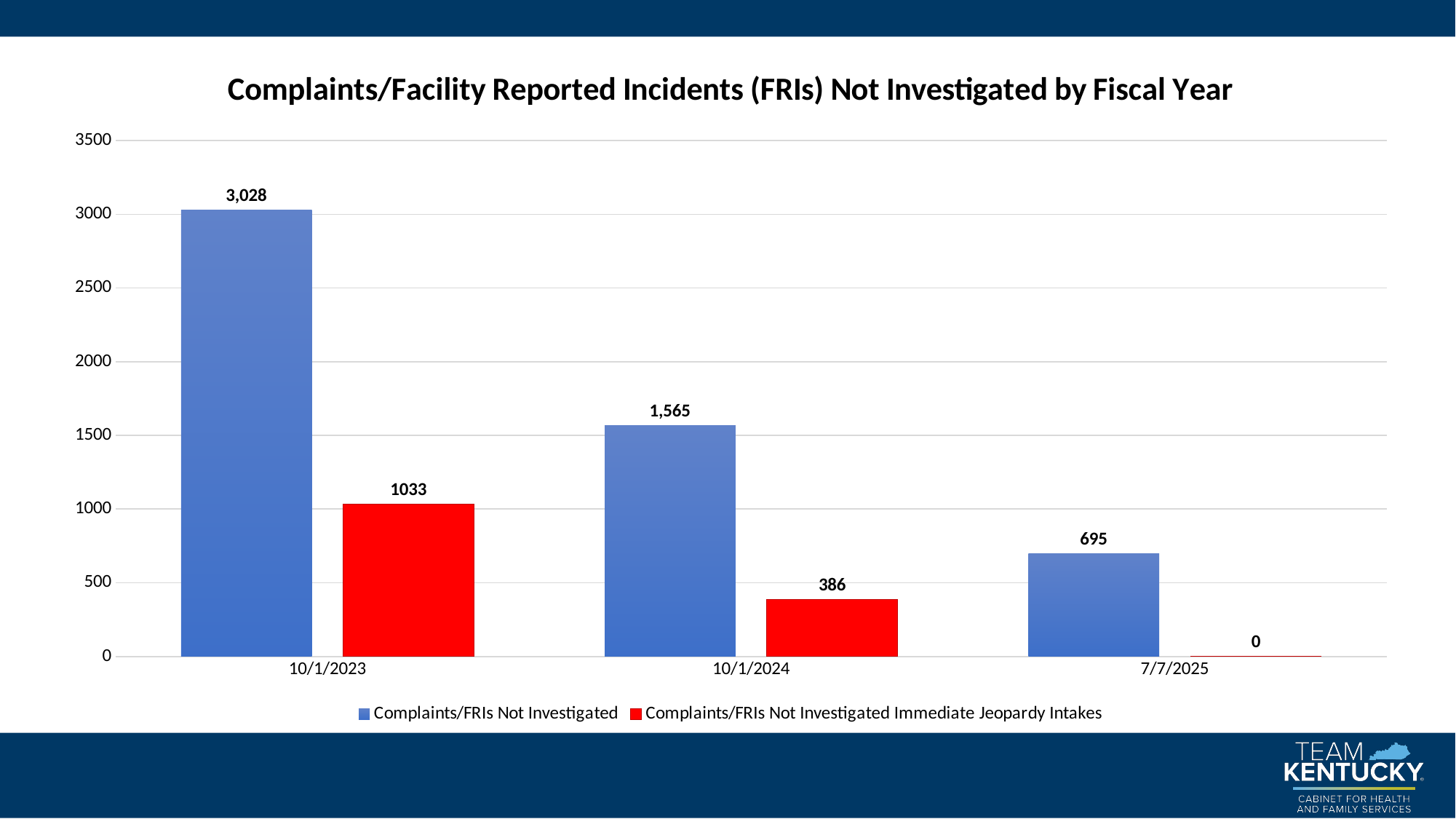
What kind of chart is shown? Bar chart What is the difference between Complaints/FRIs Not Investigated on 10/1/2023 and on 10/1/2024? 1,463 What is the value for Complaints/FRIs Not Investigated on 10/1/2023? 3,028 Which date has the highest value for Complaints/FRIs Not Investigated? 10/1/2023 Which date has the lowest value for Complaints/FRIs Not Investigated Immediate Jeopardy Intakes? 7/7/2025 What is the value for Complaints/FRIs Not Investigated Immediate Jeopardy Intakes on 10/1/2023? 1033 Do the values for Complaints/FRIs Not Investigated rise or fall across the dates from 10/1/2023 to 7/7/2025? Fall What is the value for Complaints/FRIs Not Investigated on 10/1/2024? 1,565 What is the value for Complaints/FRIs Not Investigated Immediate Jeopardy Intakes on 7/7/2025? 0 How many series does the legend list? 2 Which is larger: Complaints/FRIs Not Investigated Immediate Jeopardy Intakes on 10/1/2023 or Complaints/FRIs Not Investigated on 7/7/2025? Complaints/FRIs Not Investigated Immediate Jeopardy Intakes on 10/1/2023 How many dates are shown on the x axis? 3